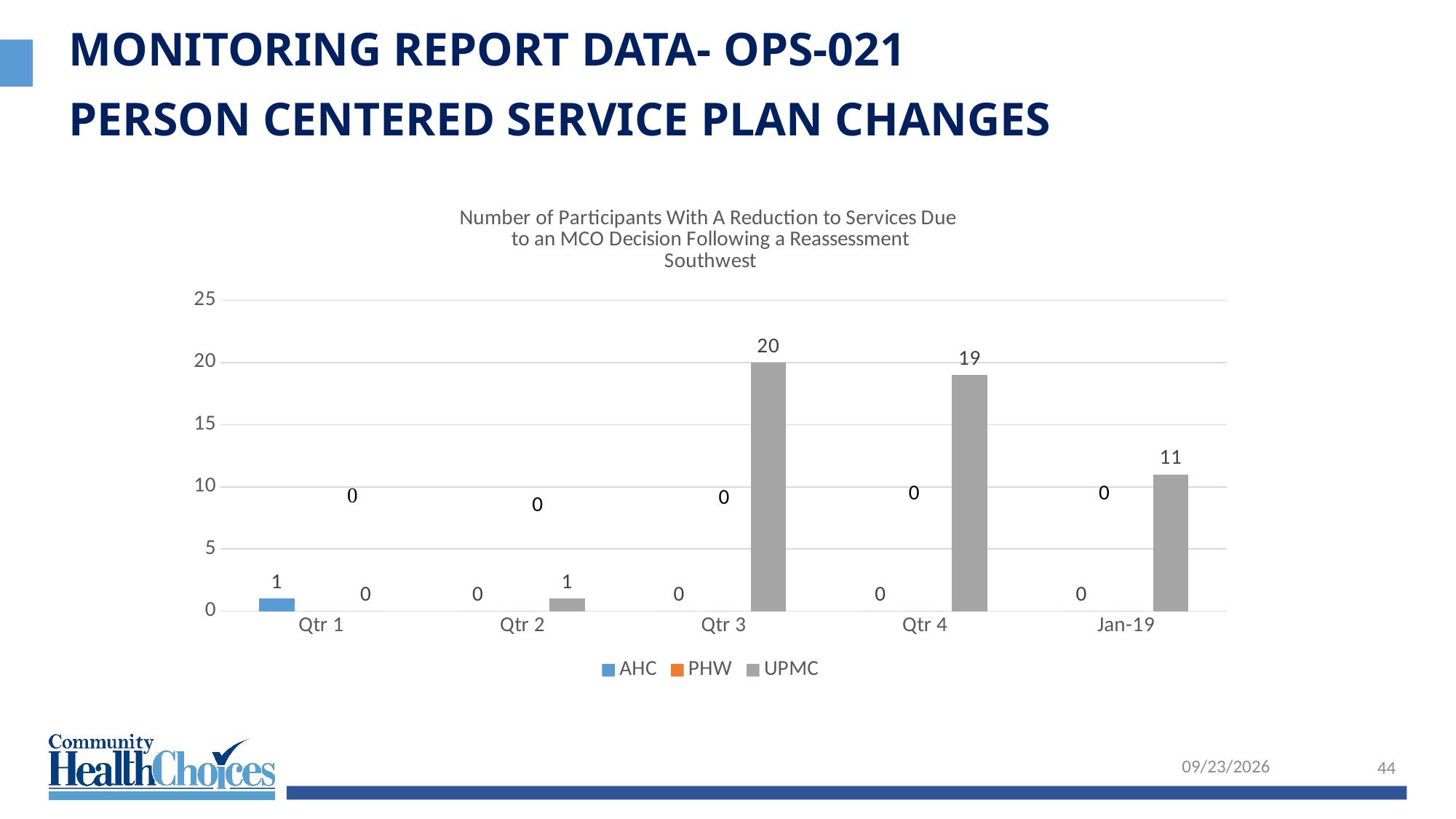
What is the AHC value for Qtr 1? 1 What is the UPMC value for Qtr 2? 1 What is the difference between the UPMC values for Qtr 3 and Qtr 4? 1 In which period is the UPMC value highest? Qtr 3 How many periods are shown on the x axis? 5 Which series is shown in gray in the legend? UPMC How many series does the legend list? 3 What is the UPMC value for Jan-19? 11 Which is larger, the UPMC value for Qtr 3 or the UPMC value for Jan-19? Qtr 3 What kind of chart is shown on the slide? Bar chart What is the UPMC value for Qtr 3? 20 What is the difference between the UPMC values for Qtr 4 and Jan-19? 8